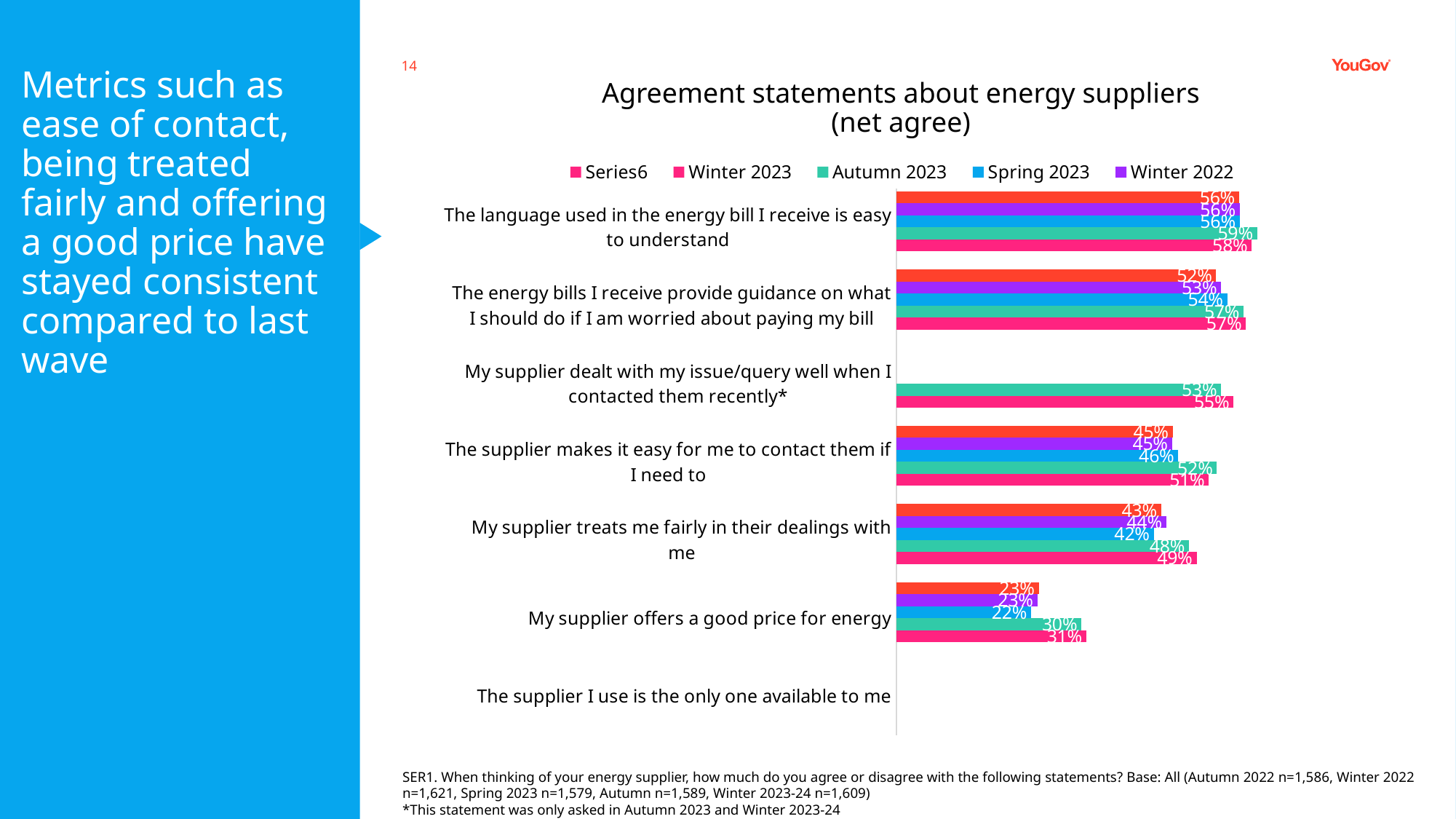
For 'The supplier makes it easy for me to contact them if I need to', which is larger: the Autumn 2023 value or the Winter 2023 value? Autumn 2023 What is the Autumn 2023 value for 'My supplier offers a good price for energy'? 30% What is the Spring 2023 value for 'My supplier treats me fairly in their dealings with me'? 42% Among the statements with plotted bars, which has the lowest Winter 2023 value? My supplier offers a good price for energy What is the title of the chart? Agreement statements about energy suppliers (net agree) What is the Winter 2023 value for 'The language used in the energy bill I receive is easy to understand'? 58% What is the difference between the Winter 2023 value (58%) and the Winter 2022 value (56%) for 'The language used in the energy bill I receive is easy to understand'? 2 percentage points What kind of chart is shown on the slide? Bar chart How many series does the legend list? 5 What is the Winter 2023 value for 'My supplier dealt with my issue/query well when I contacted them recently*'? 55% How many agreement statements are listed as categories on the chart? 7 Which statement has the highest Winter 2023 value? The language used in the energy bill I receive is easy to understand